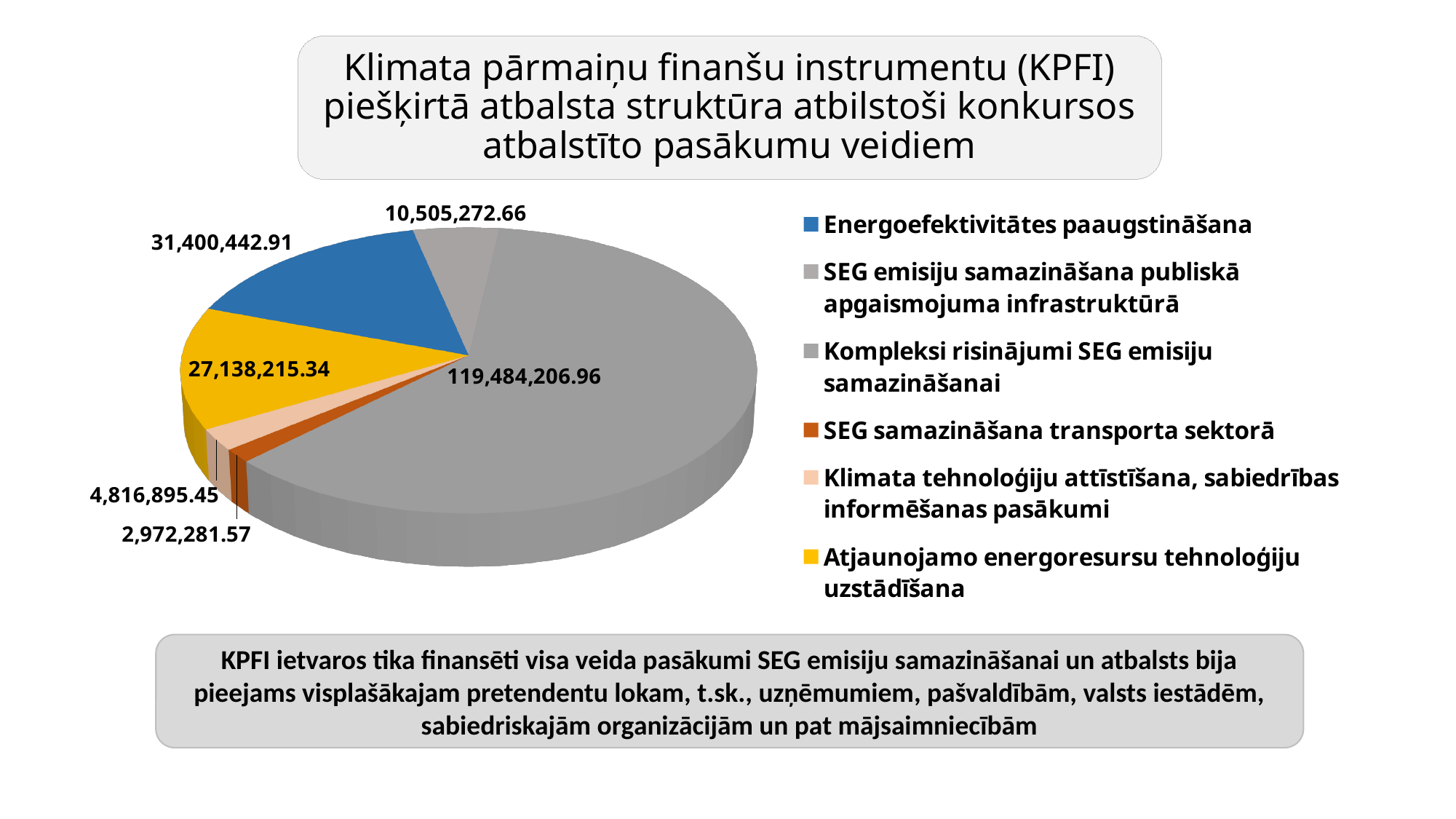
Which category has the smallest slice of the pie? SEG samazināšana transporta sektorā What type of chart is shown on the slide? Pie chart What is the value for Kompleksi risinājumi SEG emisiju samazināšanai? 119,484,206.96 What is the difference between the values for Energoefektivitātes paaugstināšana and Atjaunojamo energoresursu tehnoloģiju uzstādīšana? 4,262,227.57 What is the value for Atjaunojamo energoresursu tehnoloģiju uzstādīšana? 27,138,215.34 What colour is the slice for Atjaunojamo energoresursu tehnoloģiju uzstādīšana? Yellow Which category has the largest slice of the pie? Kompleksi risinājumi SEG emisiju samazināšanai What is the value for SEG emisiju samazināšana publiskā apgaismojuma infrastruktūrā? 10,505,272.66 What is the value for SEG samazināšana transporta sektorā? 2,972,281.57 Which is larger: Energoefektivitātes paaugstināšana or Atjaunojamo energoresursu tehnoloģiju uzstādīšana? Energoefektivitātes paaugstināšana How many categories does the legend of the pie chart list? 6 What is the value for Energoefektivitātes paaugstināšana? 31,400,442.91